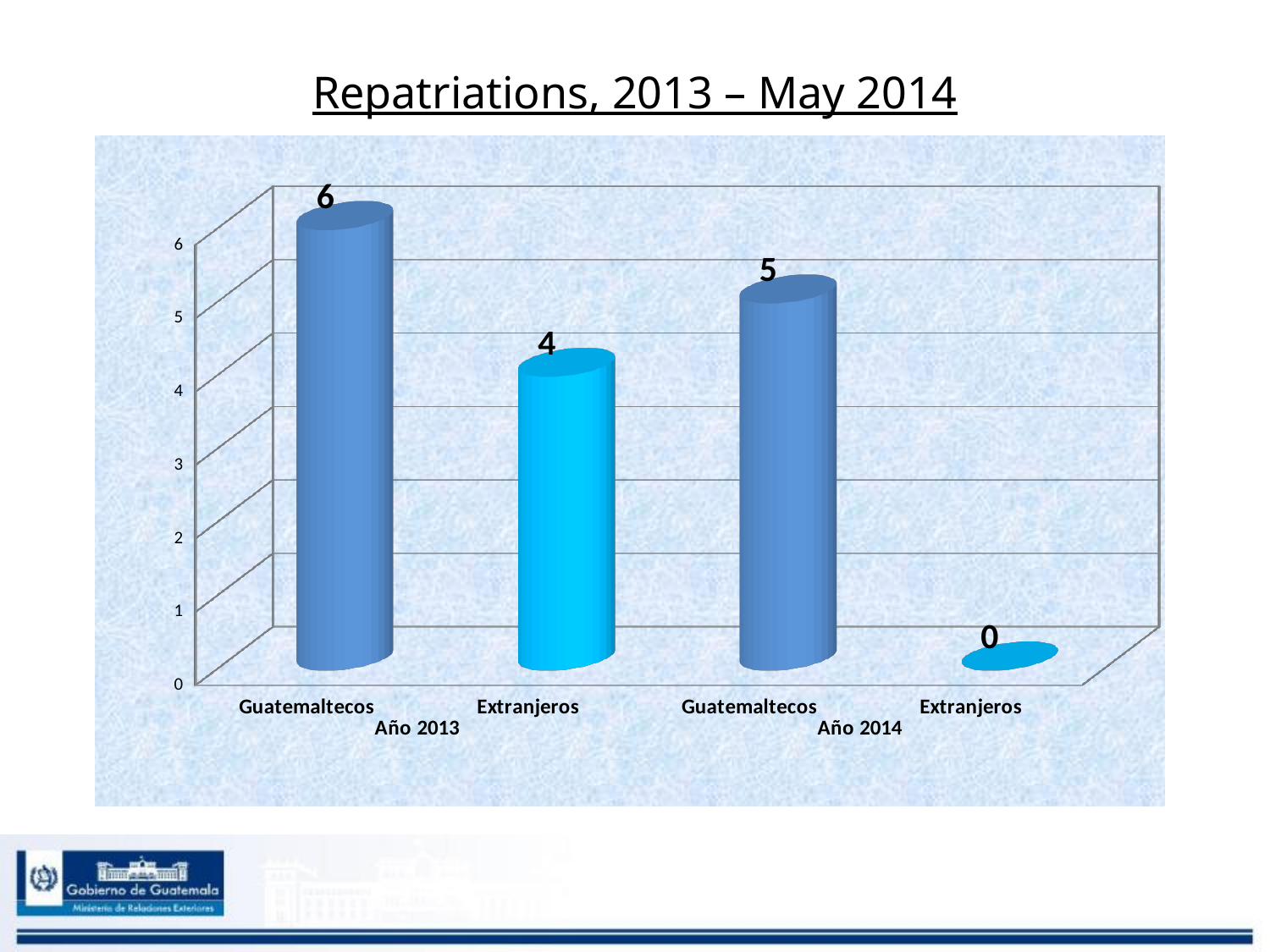
What is the difference between Guatemaltecos and Extranjeros in Año 2013? 2 What is the value for Extranjeros in Año 2014? 0 Which is larger: Extranjeros in Año 2013 or Guatemaltecos in Año 2014? Guatemaltecos in Año 2014 Which bar has the lowest value? Extranjeros, Año 2014 What is the difference between Guatemaltecos in Año 2013 and Guatemaltecos in Año 2014? 1 What is the value for Extranjeros in Año 2013? 4 Which bar has the highest value? Guatemaltecos, Año 2013 What is the title of the slide? Repatriations, 2013 – May 2014 What is the value for Guatemaltecos in Año 2013? 6 What is the value for Guatemaltecos in Año 2014? 5 What kind of chart is shown on the slide? Bar chart How many bars are plotted in the chart? 4